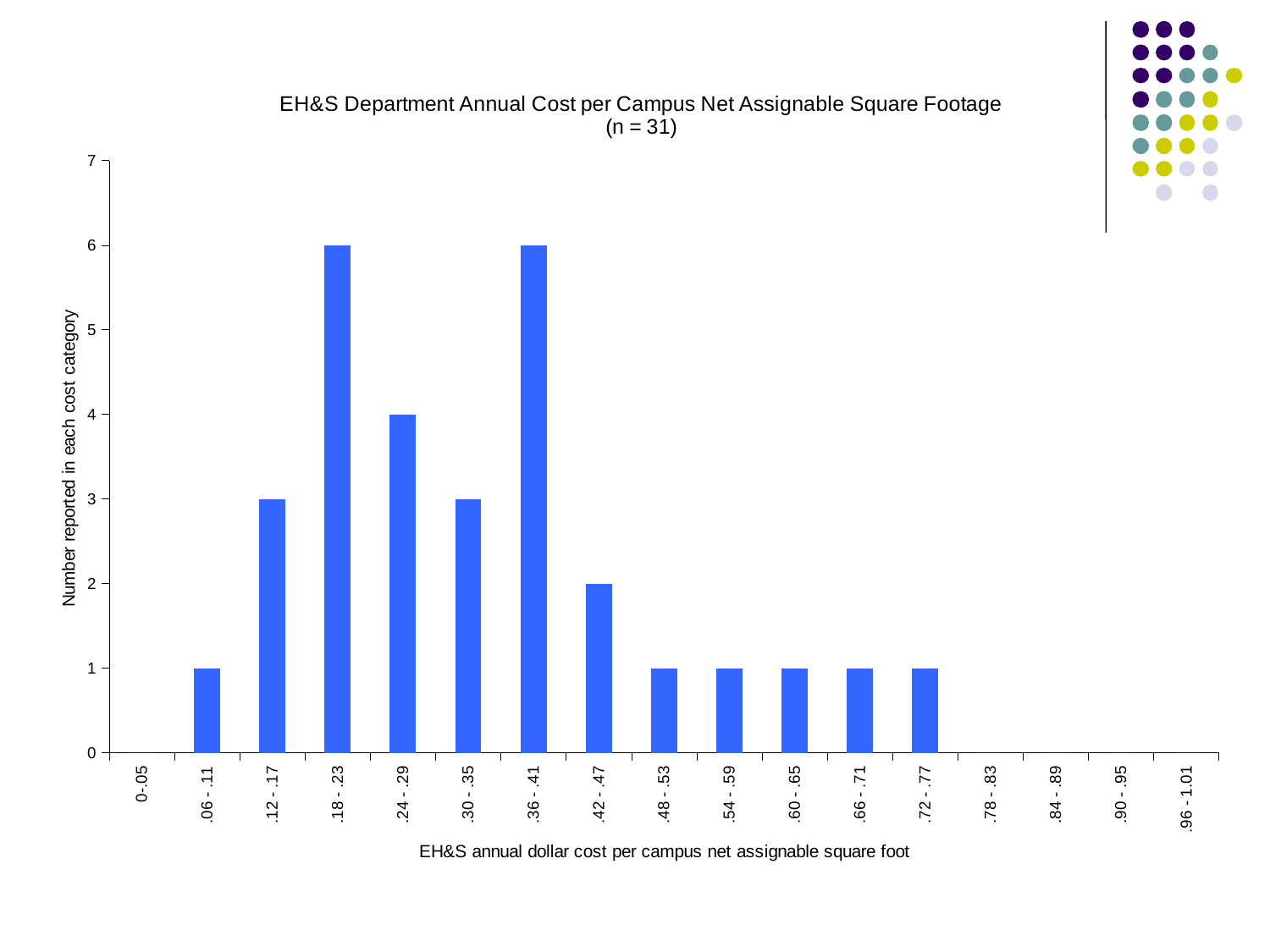
What is the number reported in the .24 - .29 cost category? 4 What is the difference between the number reported in the .36 - .41 category and the .42 - .47 category? 4 How many cost categories are shown on the x axis? 17 Which has a larger number reported: the .24 - .29 category or the .12 - .17 category? .24 - .29 What is the sample size (n) stated in the chart title? 31 What is the label of the y axis? Number reported in each cost category What is the number reported in the .42 - .47 cost category? 2 How many institutions reported a cost in the .18 - .23 category? 6 Is the value for the .18 - .23 category greater or less than 5? greater What type of chart is shown on the slide? bar chart What is the number reported in the .30 - .35 cost category? 3 What is the number reported in the .06 - .11 cost category? 1